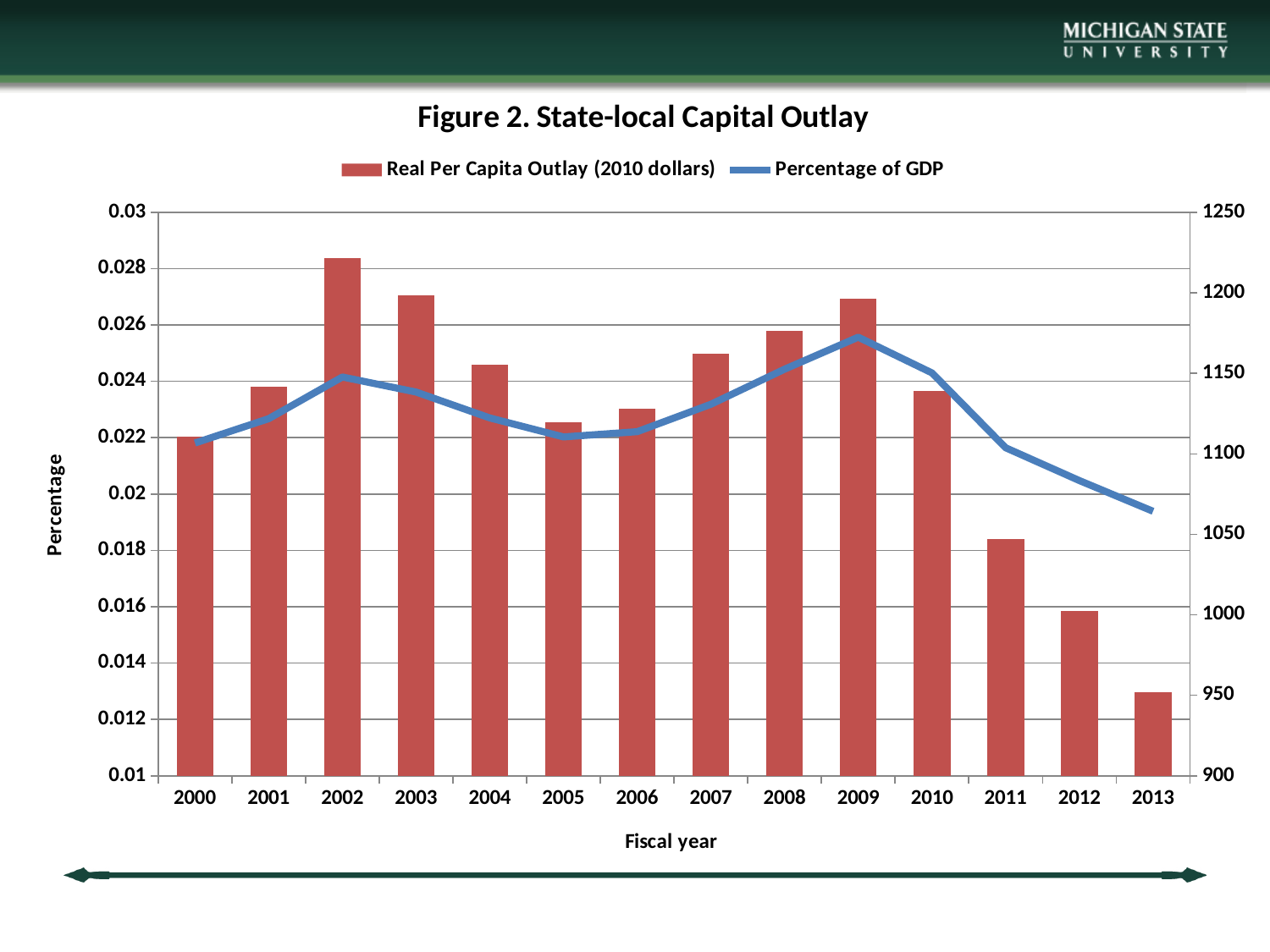
What is the title of the chart? Figure 2. State-local Capital Outlay How many series does the legend list? 2 What kind of chart is shown on the slide? A combination bar and line chart Which fiscal year has the lowest Real Per Capita Outlay bar? 2013 Which fiscal year has the highest Real Per Capita Outlay bar? 2002 In which fiscal year does the Percentage of GDP line reach its highest point? 2009 How many fiscal years are shown on the x axis? 14 Is the Real Per Capita Outlay for 2013 greater or less than 1000? less Is the Real Per Capita Outlay for 2002 greater or less than 1200? greater Is the Percentage of GDP for 2009 greater or less than 0.024? greater Which has the larger Real Per Capita Outlay, 2009 or 2010? 2009 Do the Real Per Capita Outlay bars rise or fall from 2009 to 2013? fall